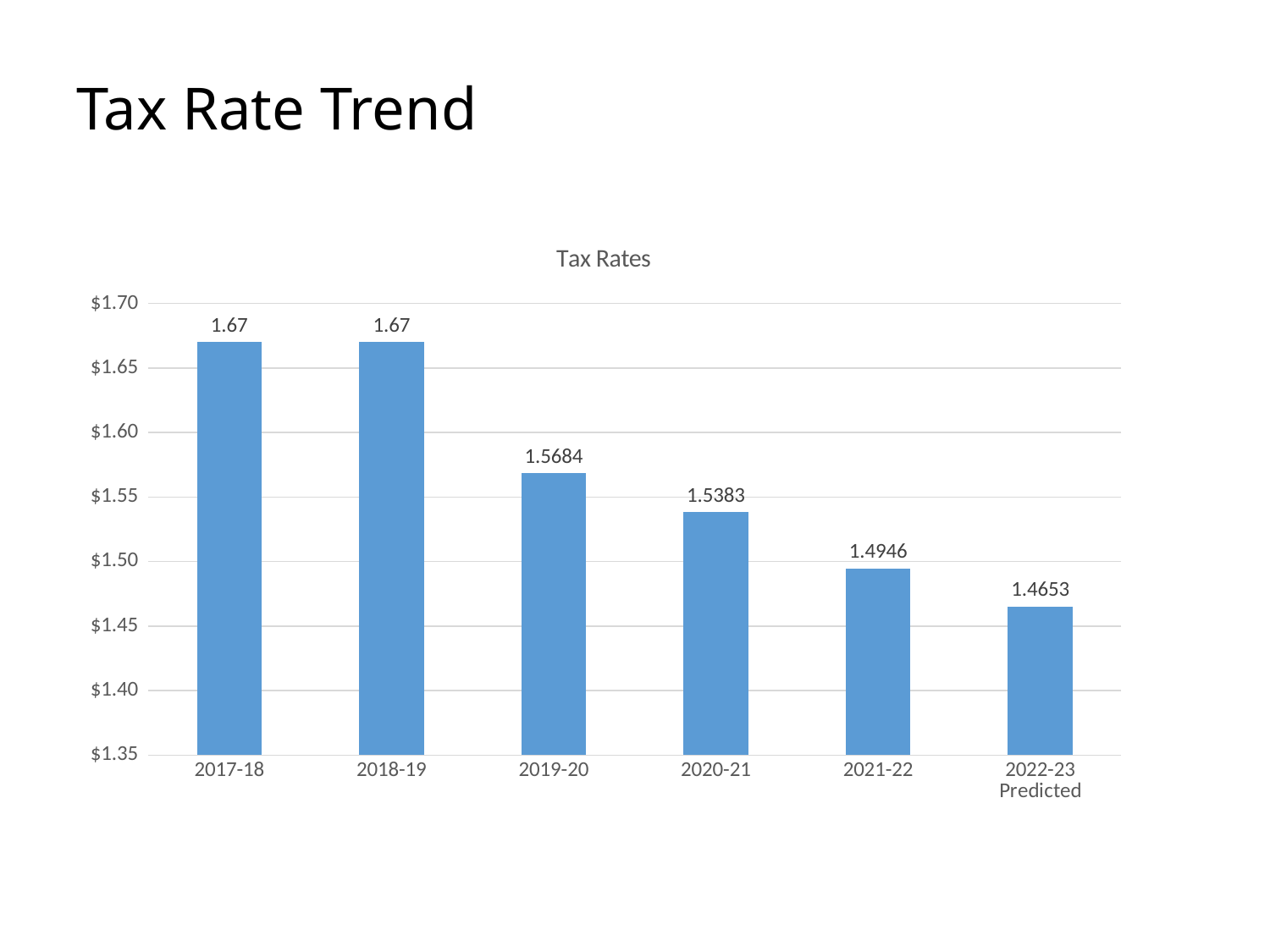
How many years are shown on the chart? 6 Which year has the lowest tax rate? 2022-23 Predicted What is the tax rate for 2021-22? 1.4946 What kind of chart is shown? Bar chart Is the tax rate for 2020-21 greater or less than $1.50? greater What is the tax rate for 2019-20? 1.5684 What is the title of the chart? Tax Rates What is the predicted tax rate for 2022-23? 1.4653 What is the difference between the tax rates for 2017-18 and 2021-22? 0.1754 Which is larger, the tax rate for 2020-21 or for 2021-22? 2020-21 Do the tax rates rise or fall from 2018-19 to 2022-23? Fall What is the difference between the tax rates for 2019-20 and 2020-21? 0.0301